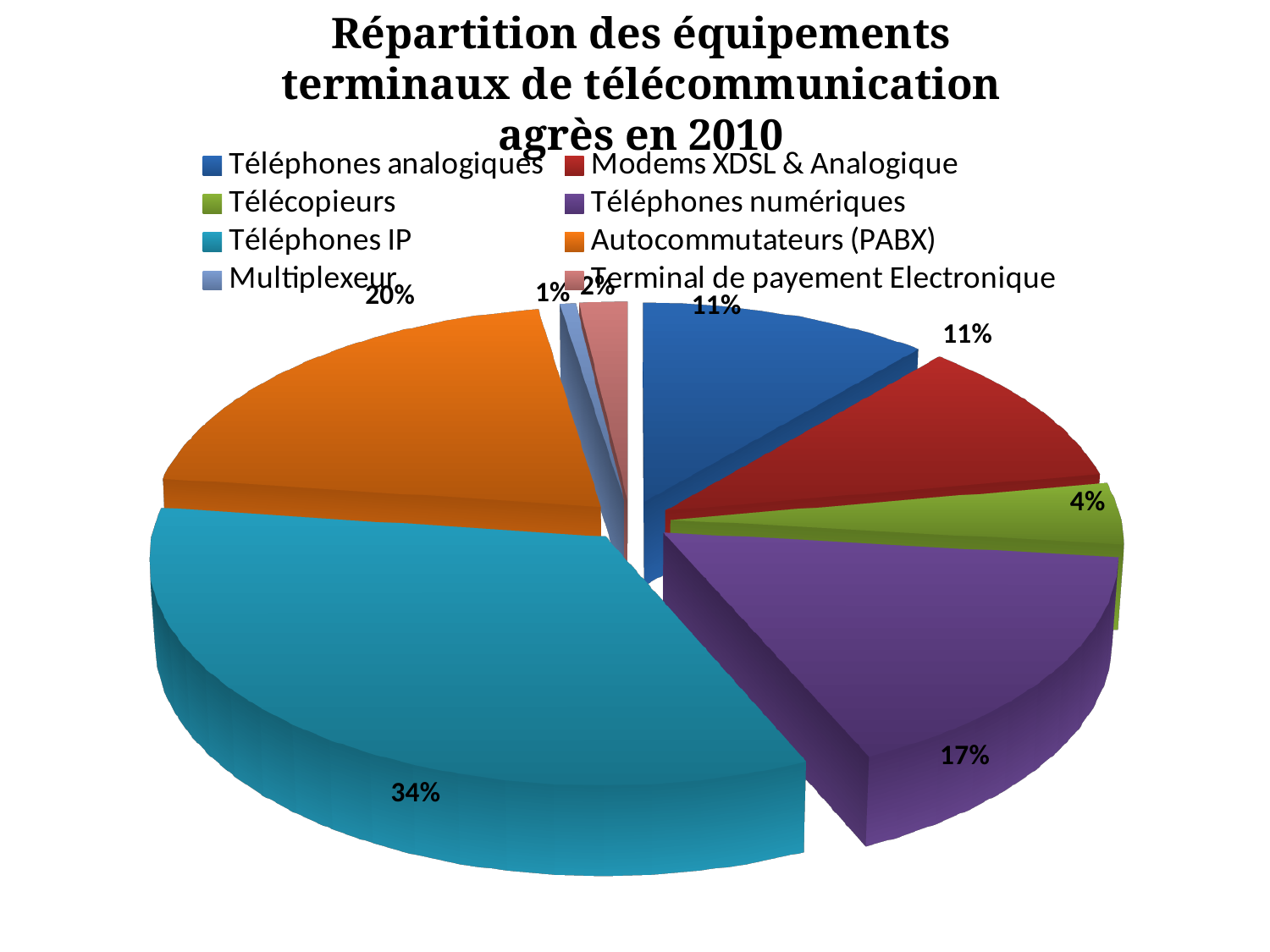
What share of the pie does Téléphones IP represent? 34% What share of the pie does Terminal de payement Electronique represent? 2% What is the difference in percentage points between Téléphones IP and Autocommutateurs (PABX)? 14 What share of the pie does Autocommutateurs (PABX) represent? 20% Which category has the smallest share of the pie? Multiplexeur Which category has the largest share of the pie? Téléphones IP What kind of chart is shown on the slide? pie chart Which is larger, the share for Téléphones numériques or the share for Télécopieurs? Téléphones numériques How many categories does the legend list? 8